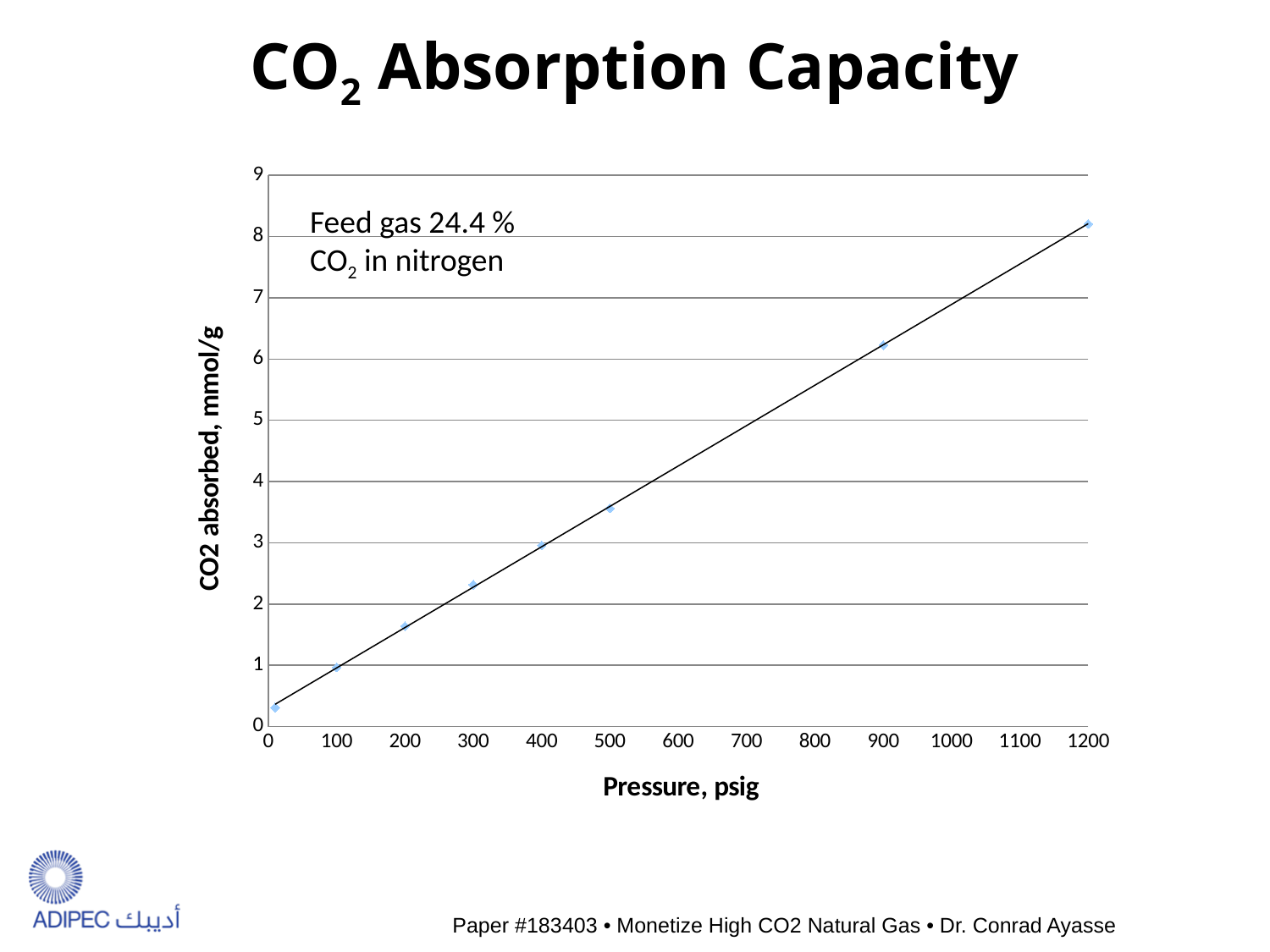
Is the CO2 absorbed at 900 psig greater or less than 5 mmol/g? greater At which pressure is the CO2 absorbed highest? 1200 psig Which pressure shows more CO2 absorbed, 500 psig or 900 psig? 900 psig What feed gas composition is noted on the chart? Feed gas 24.4 % CO2 in nitrogen Is the CO2 absorbed at 1200 psig greater or less than 7 mmol/g? greater Is the CO2 absorbed at 400 psig greater or less than 2 mmol/g? greater What kind of chart is shown on the slide? scatter chart How many data points are plotted on the chart? 8 Does the CO2 absorbed rise or fall as pressure increases along the x axis? rise What is the label of the x axis? Pressure, psig